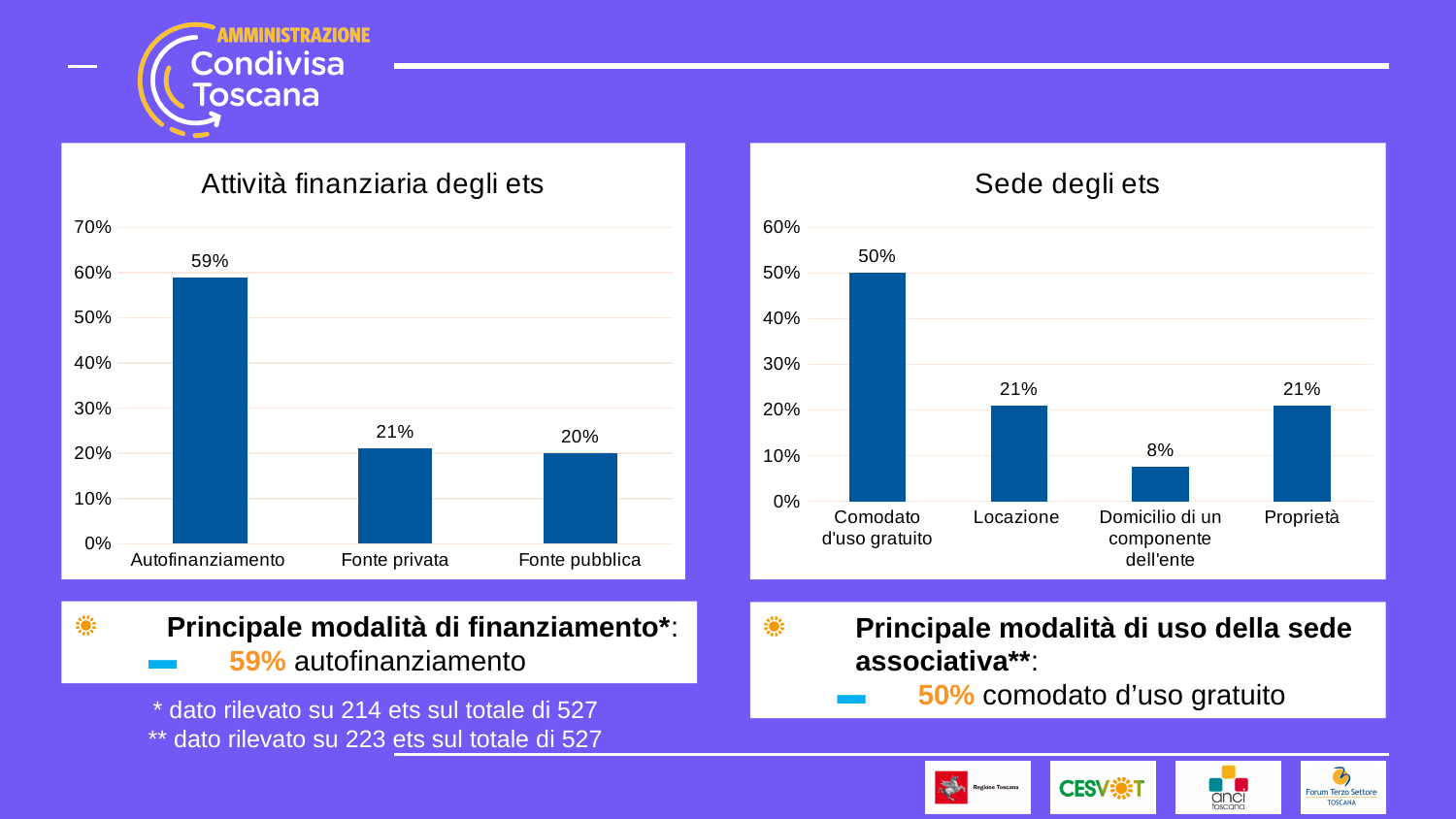
In the 'Attività finanziaria degli ets' chart, what is the value for Autofinanziamento? 59% In the 'Attività finanziaria degli ets' chart, how many categories are shown? 3 In the 'Attività finanziaria degli ets' chart, which category has the highest value? Autofinanziamento In the 'Sede degli ets' chart, what is the value for Domicilio di un componente dell'ente? 8% In the 'Sede degli ets' chart, what is the difference between Comodato d'uso gratuito and Proprietà? 29% In the 'Sede degli ets' chart, how many categories are shown? 4 In the 'Sede degli ets' chart, what is the value for Comodato d'uso gratuito? 50% What type of chart is 'Sede degli ets'? Bar chart In the 'Sede degli ets' chart, which is larger: Locazione or Domicilio di un componente dell'ente? Locazione In the 'Sede degli ets' chart, which category has the lowest value? Domicilio di un componente dell'ente In the 'Attività finanziaria degli ets' chart, what is the value for Fonte pubblica? 20% In the 'Attività finanziaria degli ets' chart, what is the difference between Autofinanziamento and Fonte privata? 38%